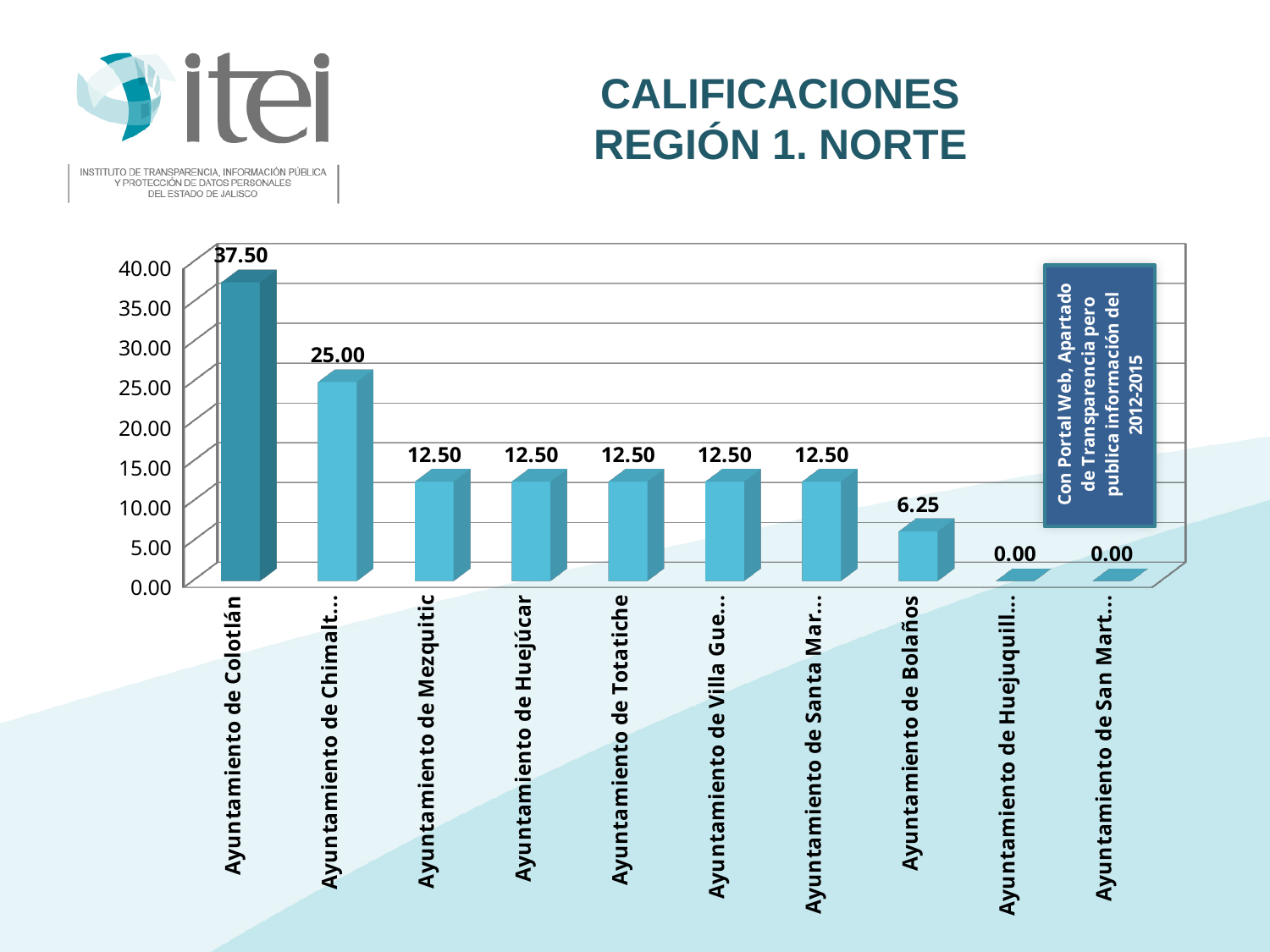
What is the difference between the values for Ayuntamiento de Totatiche and Ayuntamiento de Bolaños? 6.25 Which category has the highest value? Ayuntamiento de Colotlán What kind of chart is shown on the slide? Bar chart What is the value for Ayuntamiento de Colotlán? 37.50 What is the difference between the values for Ayuntamiento de Colotlán and Ayuntamiento de Bolaños? 31.25 How many categories have a value of 0.00? 2 What is the value for Ayuntamiento de Mezquitic? 12.50 Which is larger, the value for Ayuntamiento de Colotlán or the value for Ayuntamiento de Totatiche? Ayuntamiento de Colotlán How many categories are shown on the chart? 10 What is the value for Ayuntamiento de Huejúcar? 12.50 What is the value for Ayuntamiento de Bolaños? 6.25 Is the value for Ayuntamiento de Colotlán greater or less than 35.00? greater